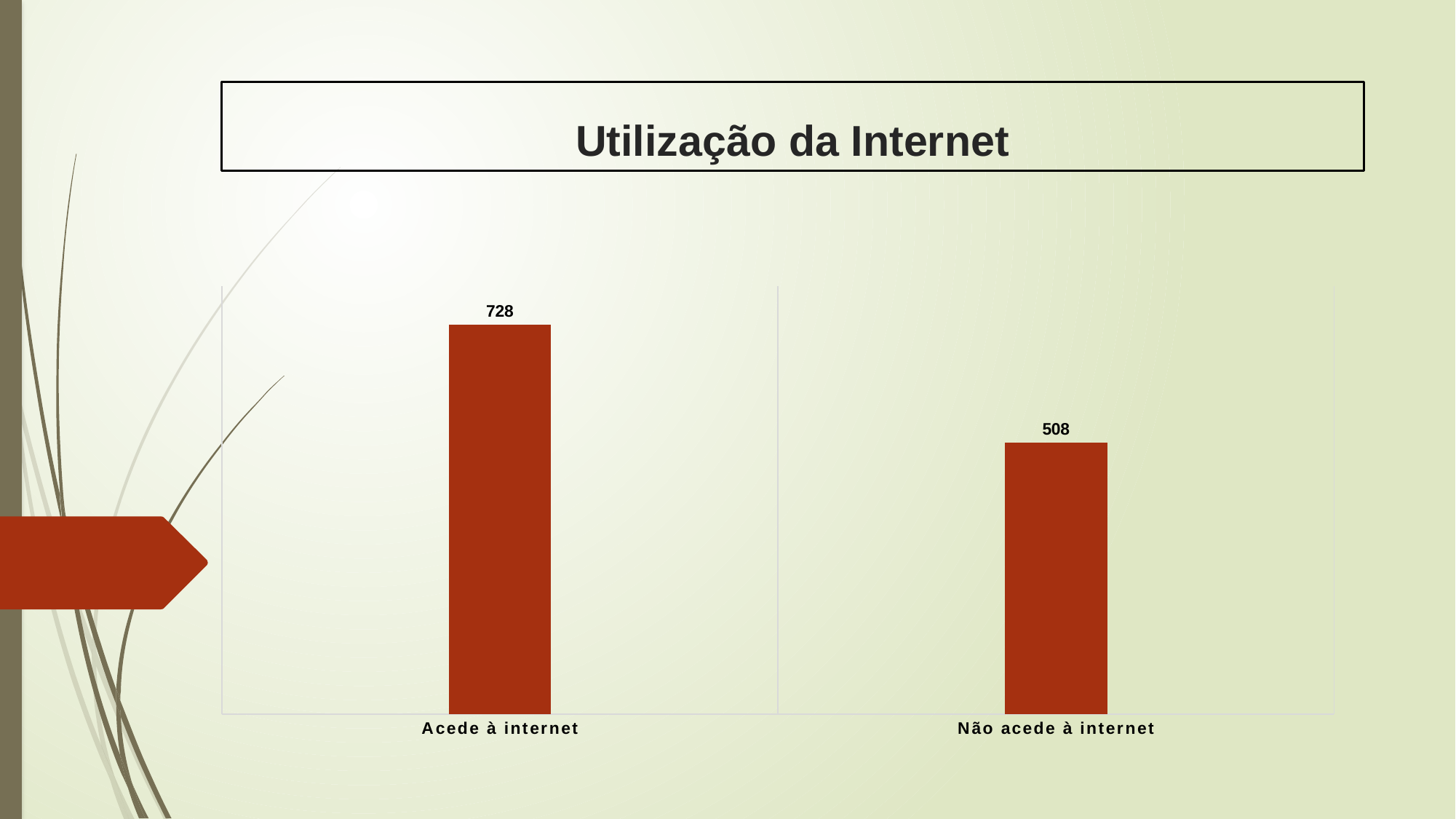
How many categories are shown in the chart? 2 What is the value for 'Não acede à internet'? 508 What is the total of the two values shown in the chart? 1236 What is the difference between the values for 'Acede à internet' and 'Não acede à internet'? 220 What is the title of the slide? Utilização da Internet What colour are the bars in the chart? Red What is the value for 'Acede à internet'? 728 What kind of chart is shown on the slide? Bar chart Which is larger: the value for 'Acede à internet' or 'Não acede à internet'? Acede à internet Which category has the highest value? Acede à internet Which category has the lowest value? Não acede à internet